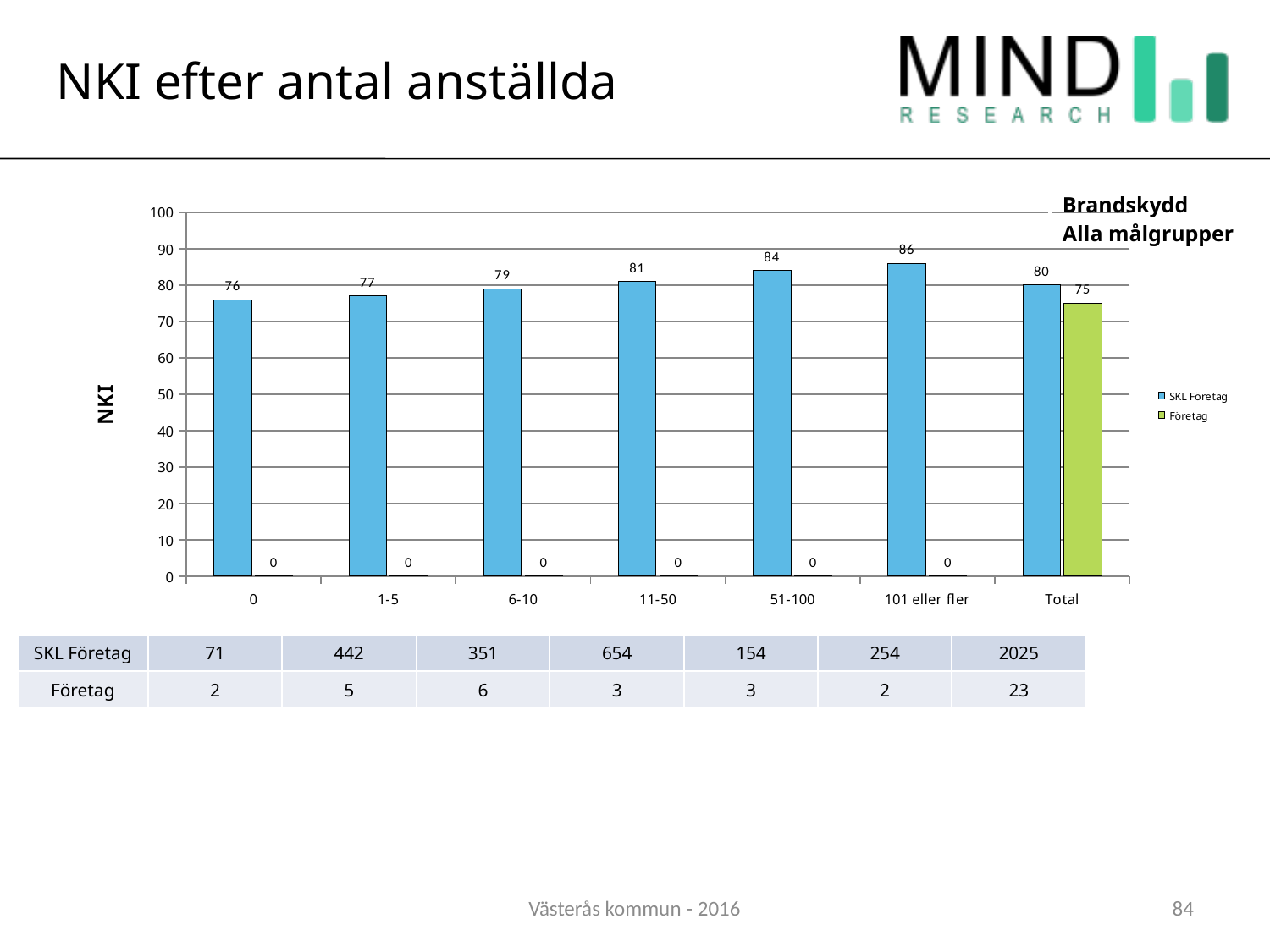
Is the SKL Företag value for '1-5' greater or less than 80? less Which category has the lowest NKI value for SKL Företag? 0 What is the NKI value for SKL Företag in the '6-10' category? 79 What is the NKI value for SKL Företag in the '101 eller fler' category? 86 What kind of chart is shown on the slide? bar chart What is the NKI value for Företag in the 'Total' category? 75 What is the difference between the SKL Företag and Företag values in the 'Total' category? 5 Which category has the highest NKI value for SKL Företag? 101 eller fler Which is larger for SKL Företag: the value for '51-100' or the value for '11-50'? 51-100 How many series does the chart legend list? 2 How many categories are shown on the x axis of the chart? 7 Do the SKL Företag values rise or fall from the '0' category to the '101 eller fler' category? rise